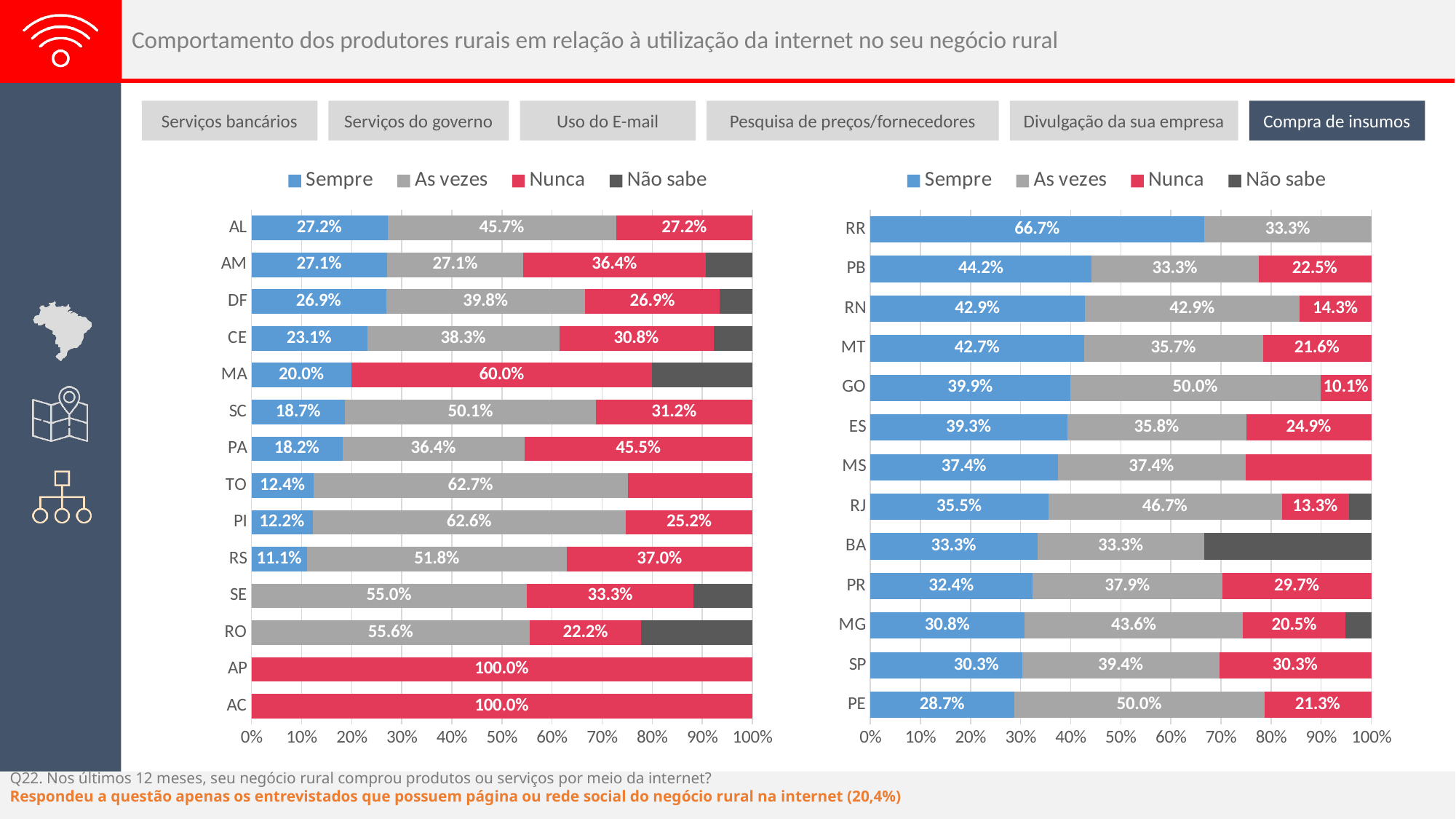
On the left chart, which has the larger 'Nunca' value, PA or SC? PA On the left chart, what is the 'Nunca' value for MA? 60.0% On the right chart, what is the 'Sempre' value for RR? 66.7% How many states are shown on the left chart? 14 On the left chart, what is the 'Sempre' value for AL? 27.2% On the right chart, which state has the highest 'Sempre' value? RR On the left chart, what is the difference between the 'Nunca' and 'Sempre' values for AM? 9.3 percentage points On the right chart, is the 'Não sabe' value for BA greater or less than 20%? greater On the right chart, what is the 'As vezes' value for PE? 50.0% On the right chart, what is the difference between the 'Sempre' and 'Nunca' values for PB? 21.7 percentage points How many series does the legend of the right chart list? 4 What type of chart is used on the left side of the slide? Stacked bar chart